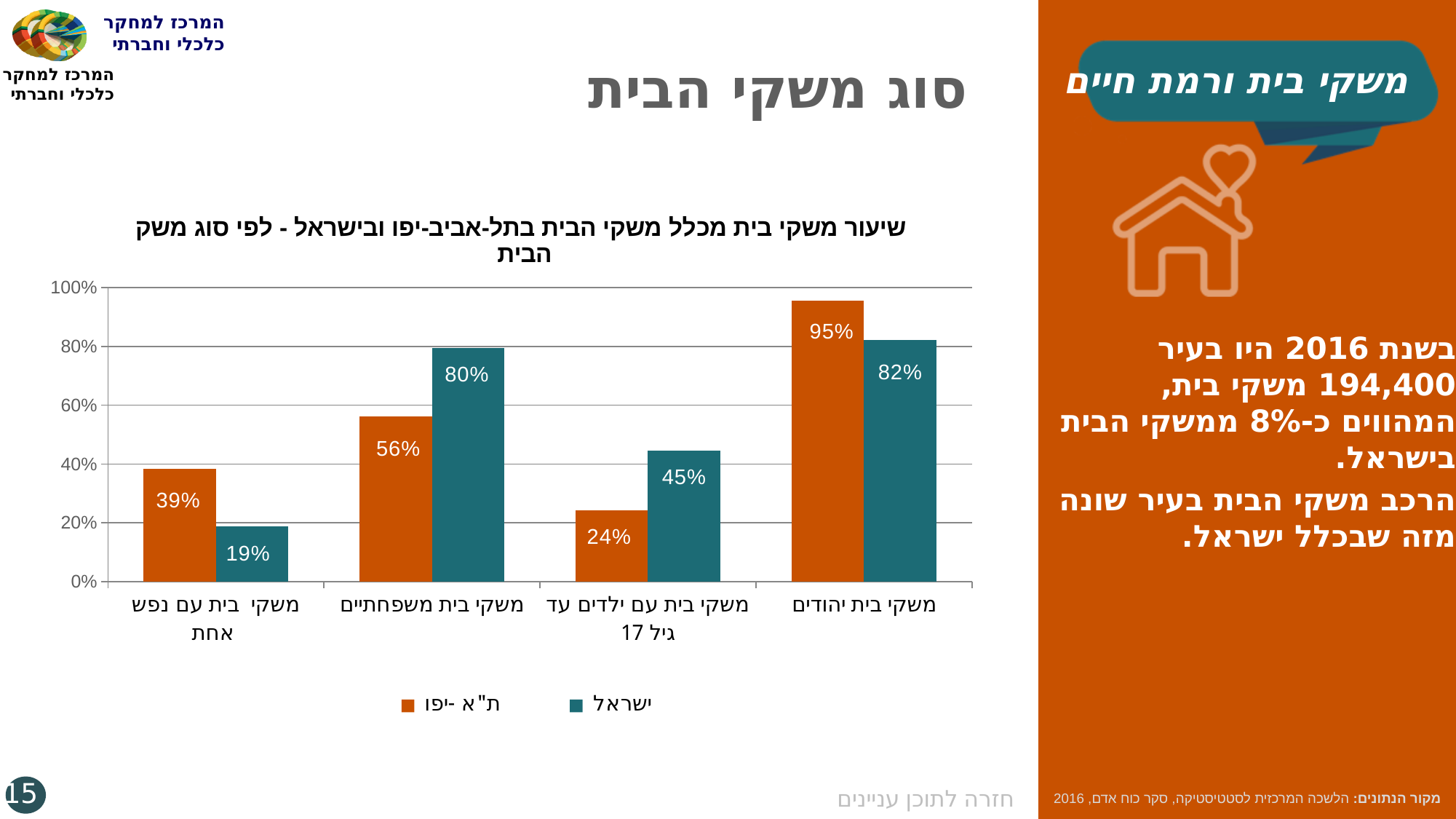
How many series does the chart legend list? 2 Which category has the lowest value for the ישראל series? משקי בית עם נפש אחת What is the value for ישראל in the category משקי בית משפחתיים? 80% What is the value for ת"א -יפו in the category משקי בית עם נפש אחת? 39% How many categories are shown on the x axis of the chart? 4 Which category has the highest value for the ת"א -יפו series? משקי בית יהודים What is the value for ישראל in the category משקי בית יהודים? 82% What kind of chart is shown on the slide? Bar chart Which colour represents the ישראל series in the chart? Teal What is the value for ת"א -יפו in the category משקי בית עם ילדים עד גיל 17? 24% What is the difference between the ישראל and ת"א -יפו values in the category משקי בית משפחתיים? 24% In the category משקי בית עם נפש אחת, which series has the larger value, ת"א -יפו or ישראל? ת"א -יפו